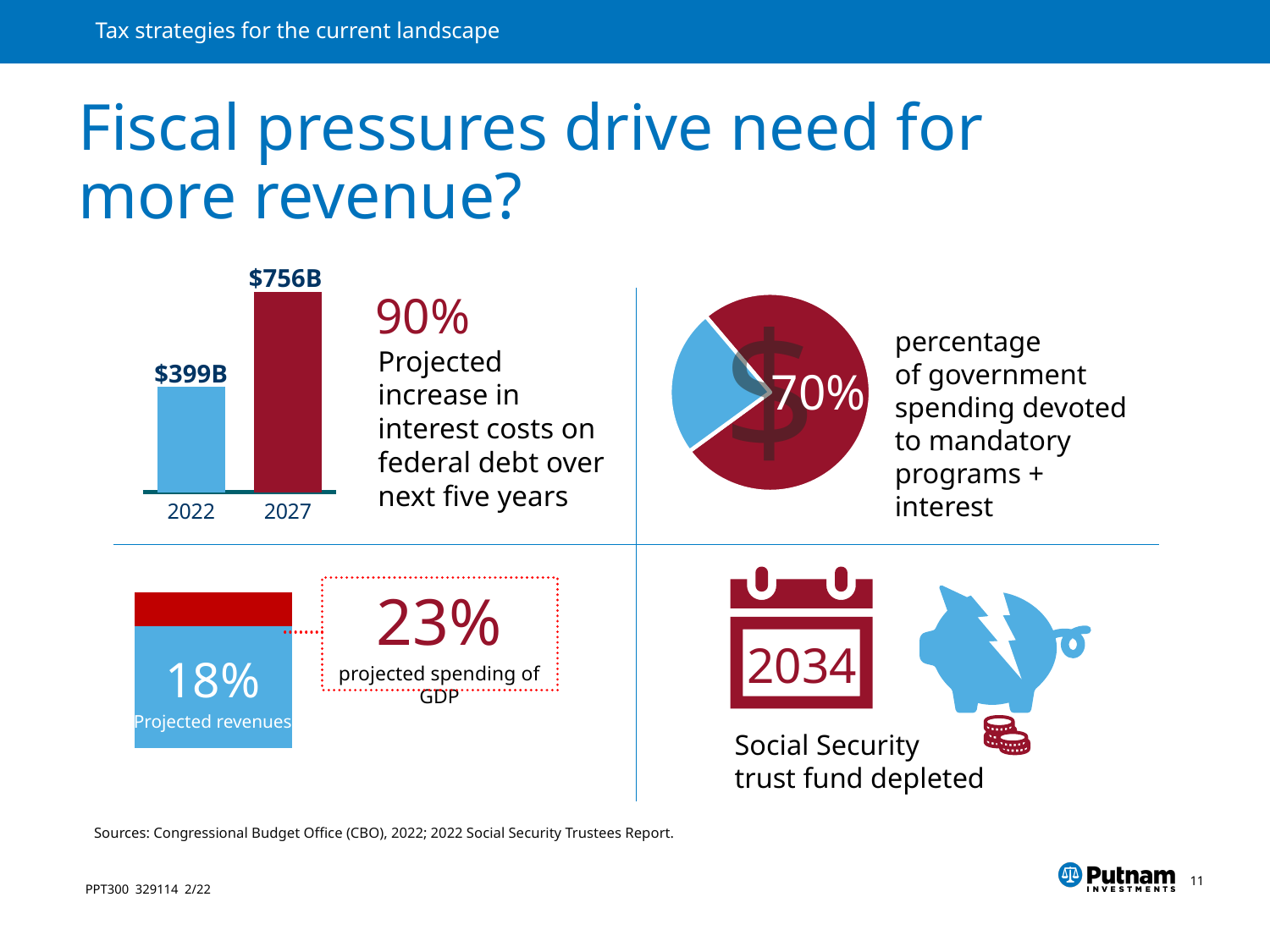
What kind of chart shows the $399B and $756B values? bar chart In the bar chart on the left, which year has the lower value? 2022 In the bar chart on the left, what is the value for 2022? $399B How many bars are shown in the bar chart on the left? 2 In the pie chart on the right, what percentage of government spending is devoted to mandatory programs + interest? 70% In the bar chart on the left, is the value for 2027 larger or smaller than the value for 2022? larger In the bar chart on the left, what is the value for 2027? $756B In the bottom-left graphic, what is the difference between projected spending of GDP (23%) and projected revenues (18%)? 5% In the bar chart on the left, what is the difference between the 2027 and 2022 values? $357B In the bar chart on the left, do the values rise or fall from 2022 to 2027? rise In the bar chart on the left, which year has the higher value? 2027 In the bottom-left graphic, what is the value for projected revenues? 18%